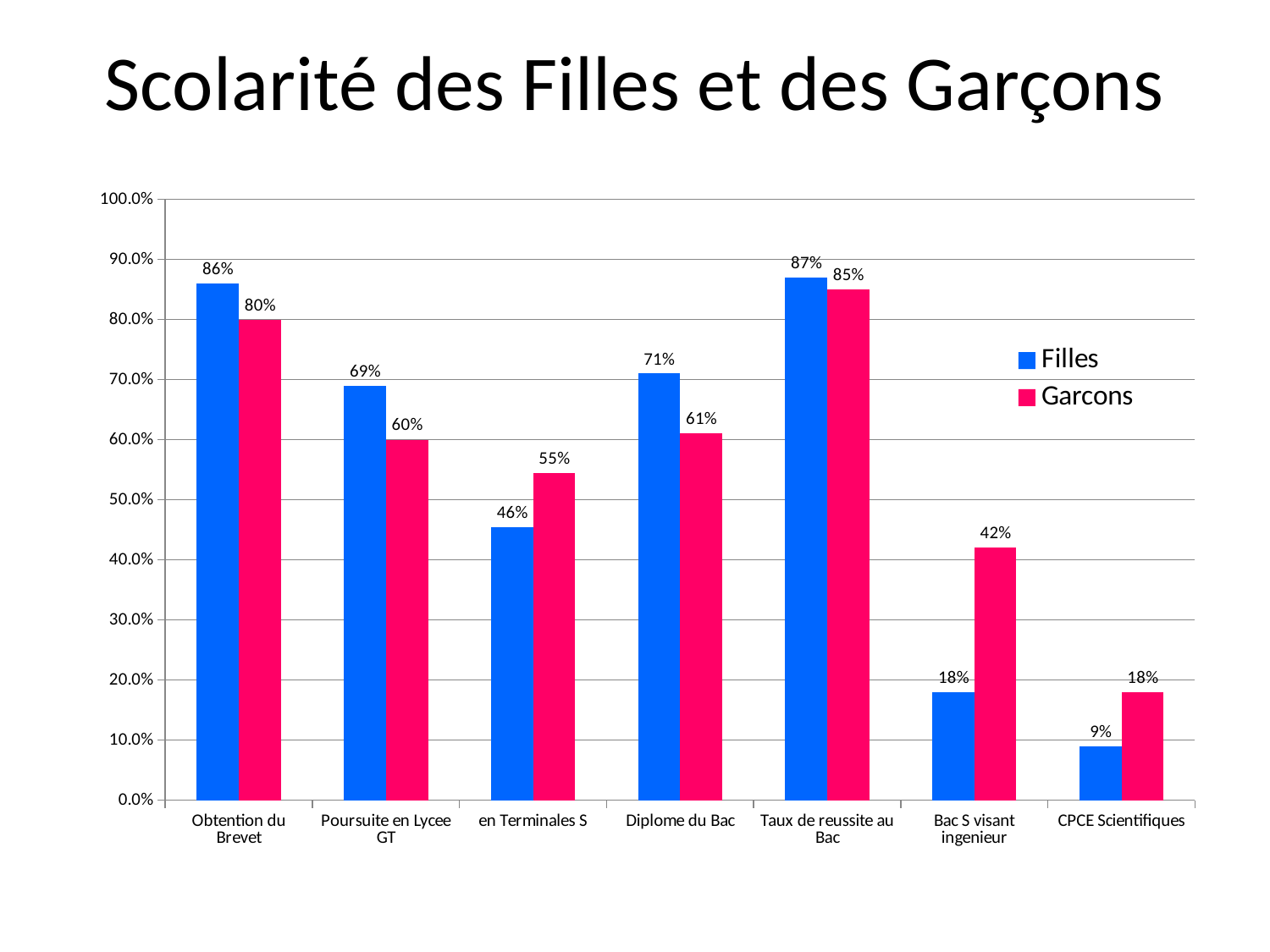
Is the value for Garcons in the Diplome du Bac category greater or less than 70%? less What is the difference between Garcons and Filles in the Bac S visant ingenieur category? 24% What is the value for Filles in the CPCE Scientifiques category? 9% What is the value for Garcons in the Bac S visant ingenieur category? 42% Which category has the highest value for Filles? Taux de reussite au Bac What colour represents the Garcons series? pink How many categories are shown on the x axis? 7 In the en Terminales S category, which series has the larger value, Filles or Garcons? Garcons What kind of chart is shown on the slide? bar chart How many series does the legend list? 2 What is the value for Filles in the Obtention du Brevet category? 86%